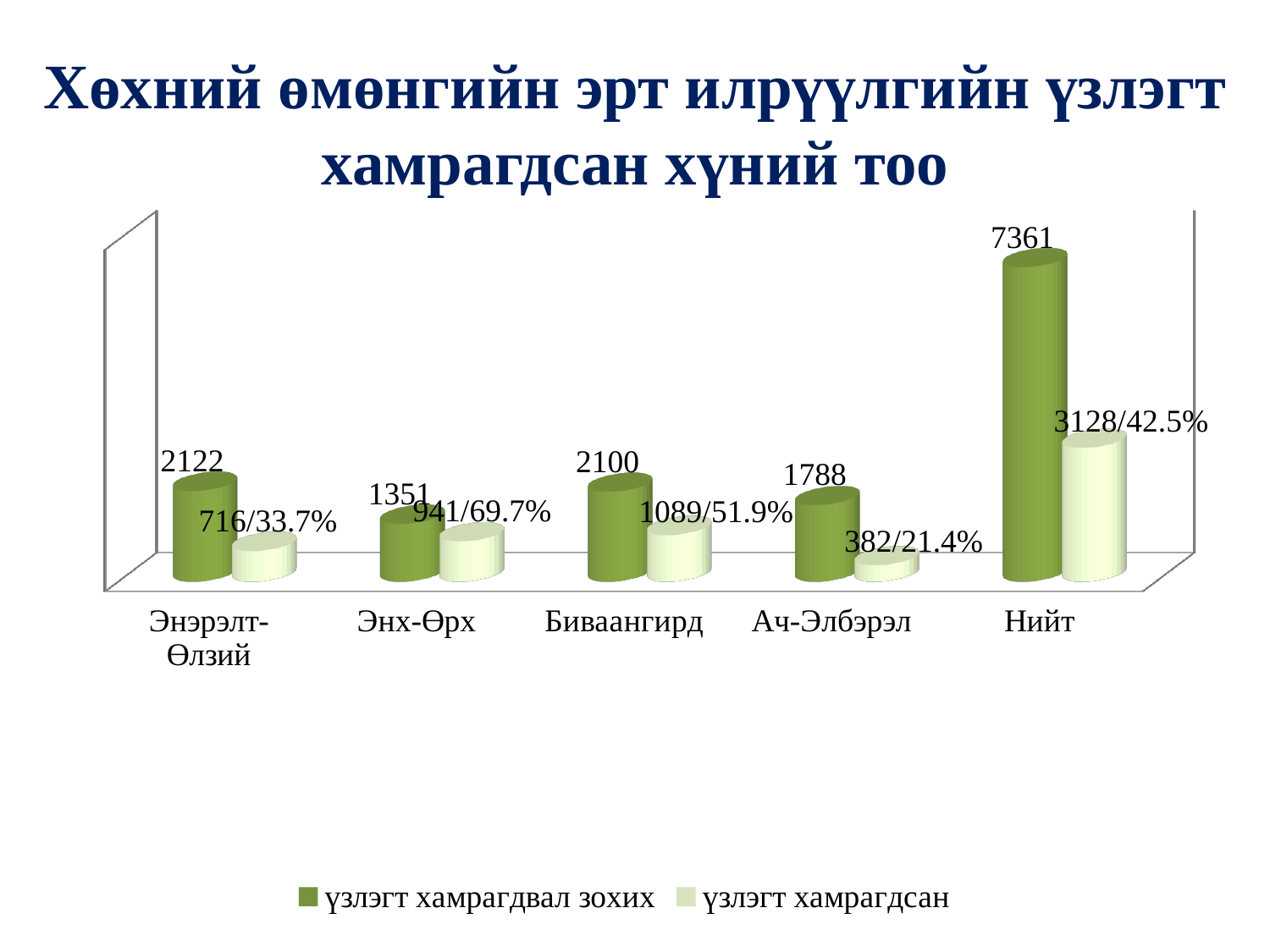
What is the value of the "үзлэгт хамрагдвал зохих" series for Энэрэлт-Өлзий? 2122 What data label is shown for the "үзлэгт хамрагдсан" series for Энх-Өрх? 941/69.7% What is the value of the "үзлэгт хамрагдвал зохих" series for Биваангирд? 2100 How many series does the legend list? 2 Which is larger: the "үзлэгт хамрагдвал зохих" value for Биваангирд or for Ач-Элбэрэл? Биваангирд What kind of chart is shown on the slide? Bar chart Which category has the highest value in the "үзлэгт хамрагдвал зохих" series? Нийт What data label is shown for the "үзлэгт хамрагдсан" series for Ач-Элбэрэл? 382/21.4% Which category has the lowest value in the "үзлэгт хамрагдсан" series? Ач-Элбэрэл How many categories are shown on the x axis? 5 What is the difference between the "үзлэгт хамрагдвал зохих" values for Энэрэлт-Өлзий and Энх-Өрх? 771 What is the value of the "үзлэгт хамрагдвал зохих" series for Нийт? 7361